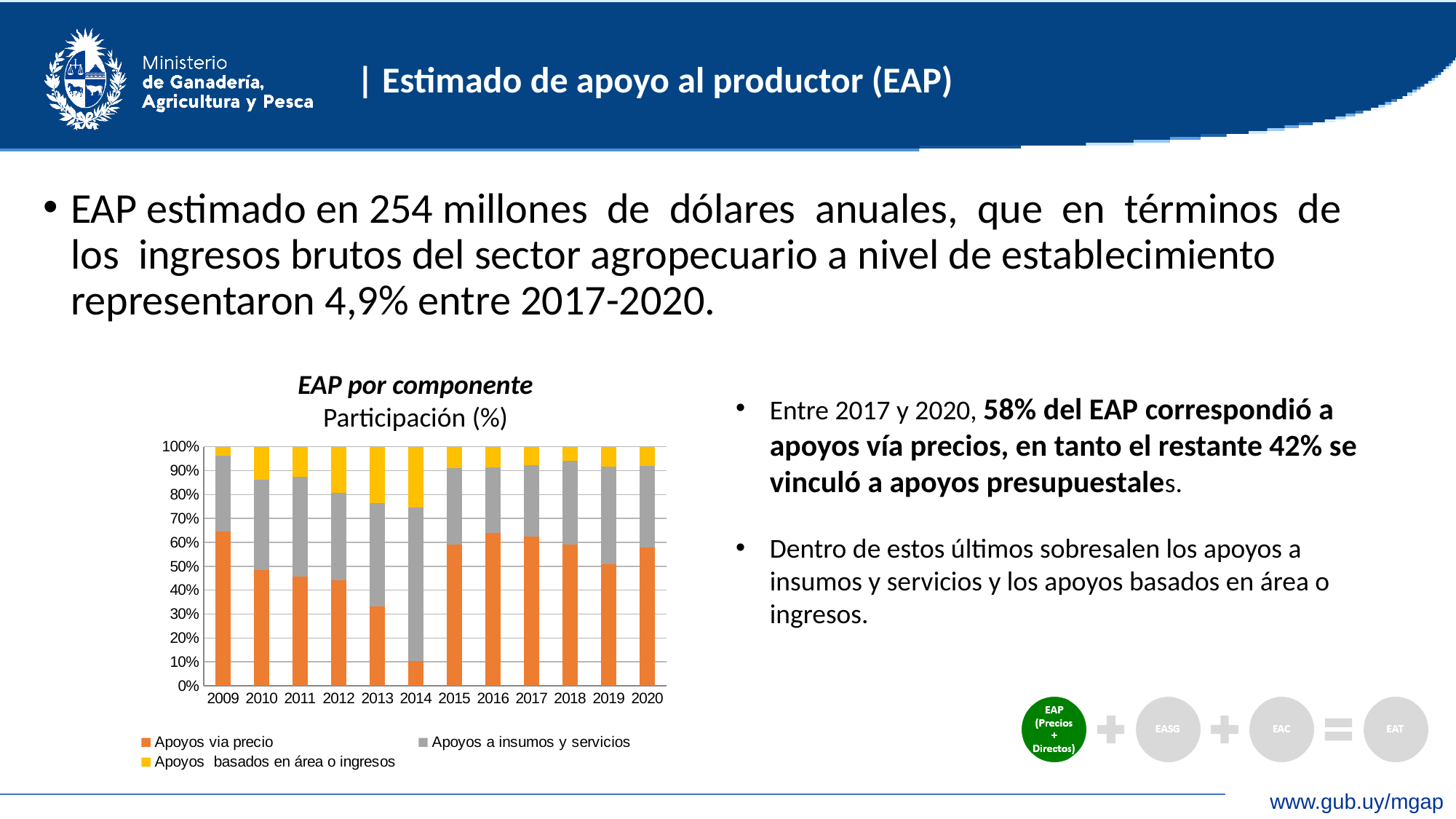
In which year is the share of 'Apoyos via precio' the lowest? 2014 How many years are shown on the x axis of the chart? 12 In which year is the share of 'Apoyos a insumos y servicios' the highest? 2014 Is the share of 'Apoyos via precio' in 2009 greater or less than 60%? greater How many series does the chart legend list? 3 Is the share of 'Apoyos via precio' in 2014 greater or less than 20%? less Which colour represents 'Apoyos via precio' in the chart? Orange What does each stacked bar in the chart total? 100% Does the share of 'Apoyos via precio' rise or fall from 2009 to 2014? fall In which year is the share of 'Apoyos basados en área o ingresos' the smallest? 2009 Which year has a larger share of 'Apoyos via precio', 2013 or 2016? 2016 What kind of chart is shown on the slide? Stacked bar chart